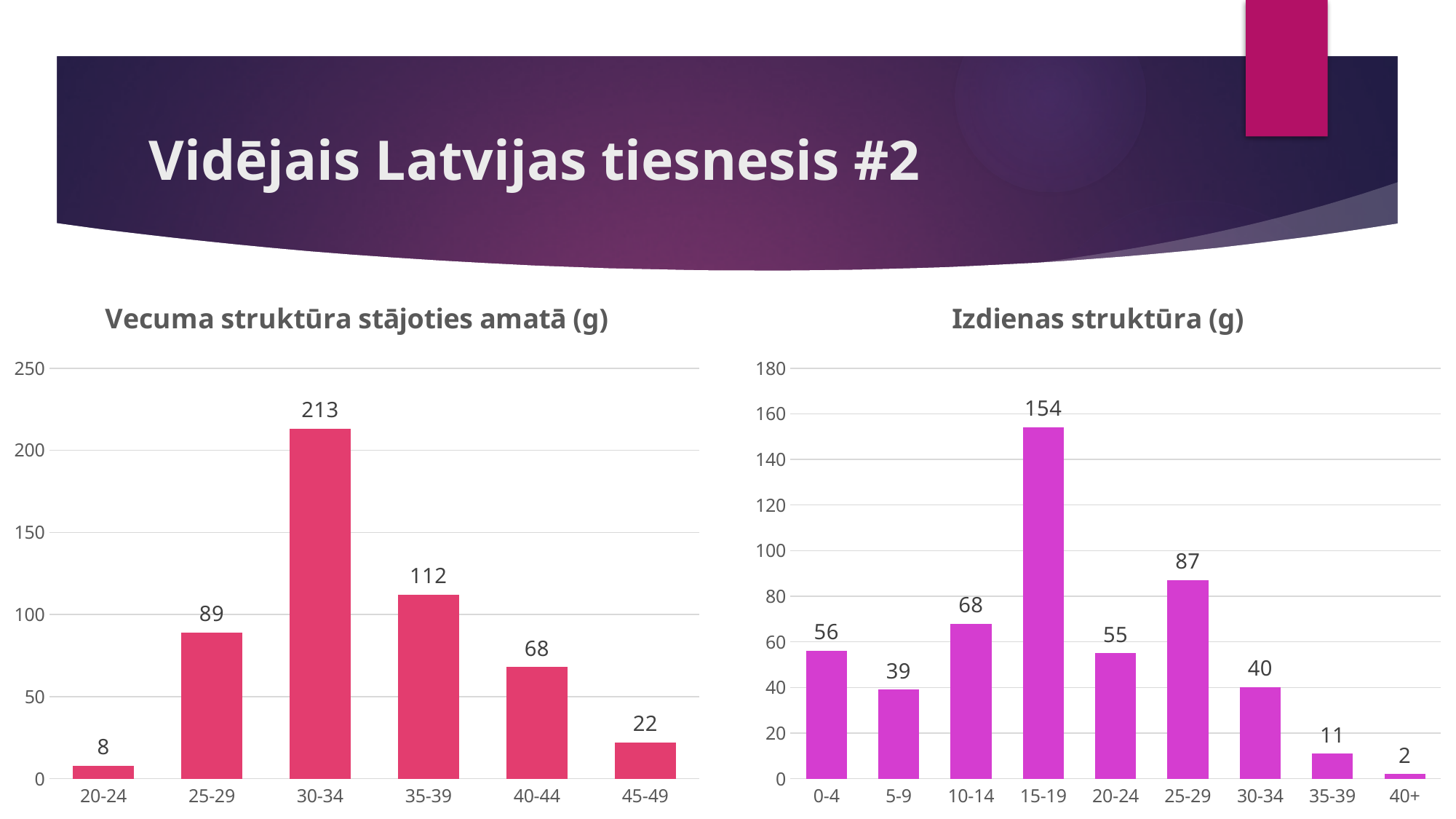
In the chart titled "Vecuma struktūra stājoties amatā (g)", do the values rise or fall from 30-34 to 45-49? Fall In the chart titled "Izdienas struktūra (g)", which category has the lowest value? 40+ In the chart titled "Vecuma struktūra stājoties amatā (g)", how many categories are shown on the x axis? 6 In the chart titled "Vecuma struktūra stājoties amatā (g)", which is larger, the value for 25-29 or the value for 40-44? 25-29 In the chart titled "Izdienas struktūra (g)", what is the difference between the values for 0-4 and 5-9? 17 In the chart titled "Vecuma struktūra stājoties amatā (g)", what is the difference between the values for 30-34 and 35-39? 101 In the chart titled "Vecuma struktūra stājoties amatā (g)", what is the value for the 30-34 category? 213 In the chart titled "Vecuma struktūra stājoties amatā (g)", which category has the lowest value? 20-24 In the chart titled "Izdienas struktūra (g)", what is the value for the 25-29 category? 87 What kind of chart is the chart titled "Izdienas struktūra (g)"? Bar chart In the chart titled "Izdienas struktūra (g)", how many categories are shown on the x axis? 9 In the chart titled "Izdienas struktūra (g)", which category has the highest value? 15-19